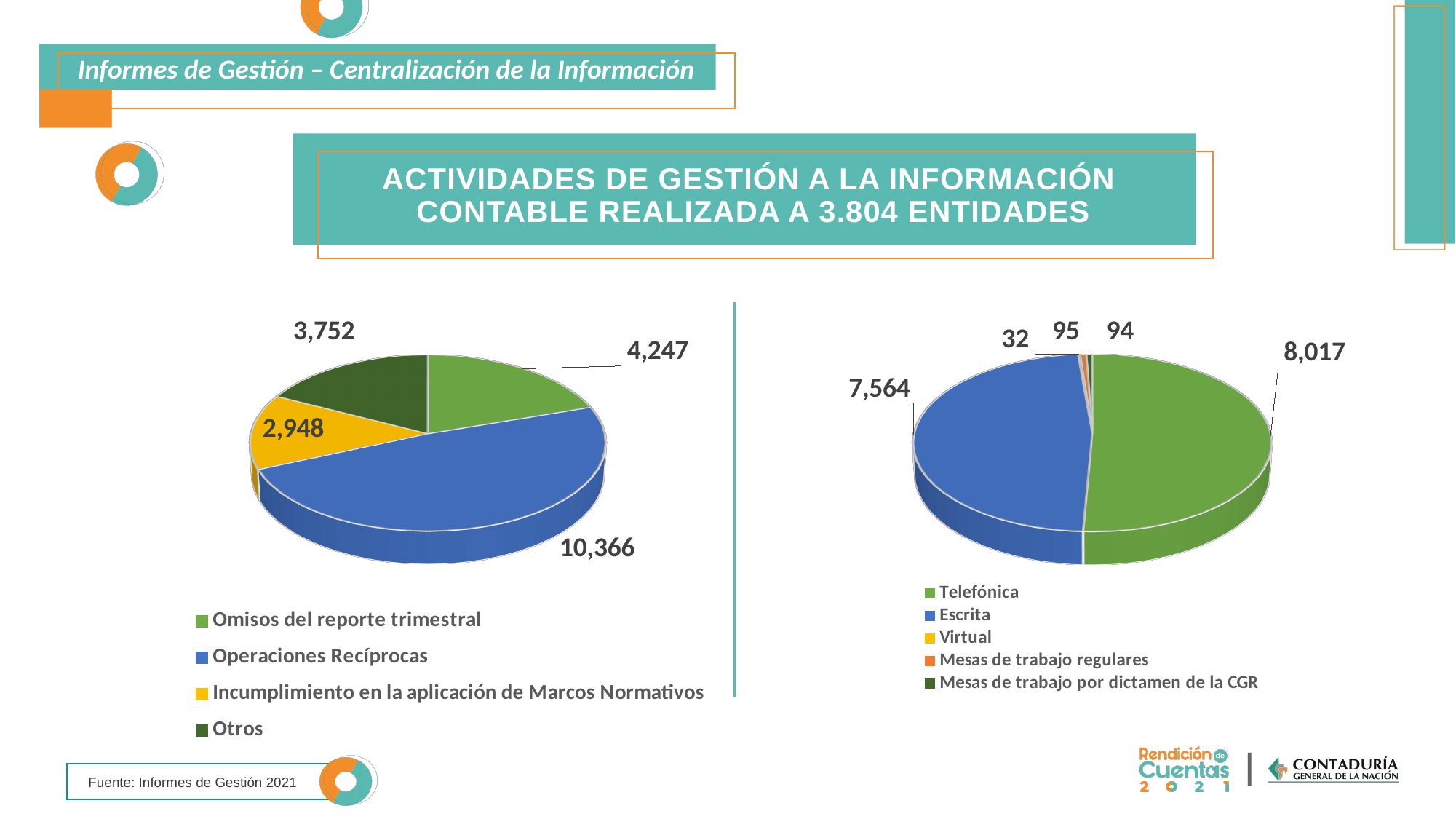
How many categories does the legend of the right pie chart list? 5 In the right pie chart, what is the value for Telefónica? 8,017 In the left pie chart, what is the difference between Operaciones Recíprocas and Omisos del reporte trimestral? 6,119 In the left pie chart, what is the value for Incumplimiento en la aplicación de Marcos Normativos? 2,948 In the left pie chart, what is the value for Operaciones Recíprocas? 10,366 In the left pie chart, what is the value for Otros? 3,752 In the right pie chart, what is the value for Escrita? 7,564 In the left pie chart, which category has the smallest value? Incumplimiento en la aplicación de Marcos Normativos In the right pie chart, which is larger, Telefónica or Escrita? Telefónica In the left pie chart, what is the value for Omisos del reporte trimestral? 4,247 What type of chart is shown on the left side of the slide? Pie chart In the left pie chart, which category has the largest value? Operaciones Recíprocas